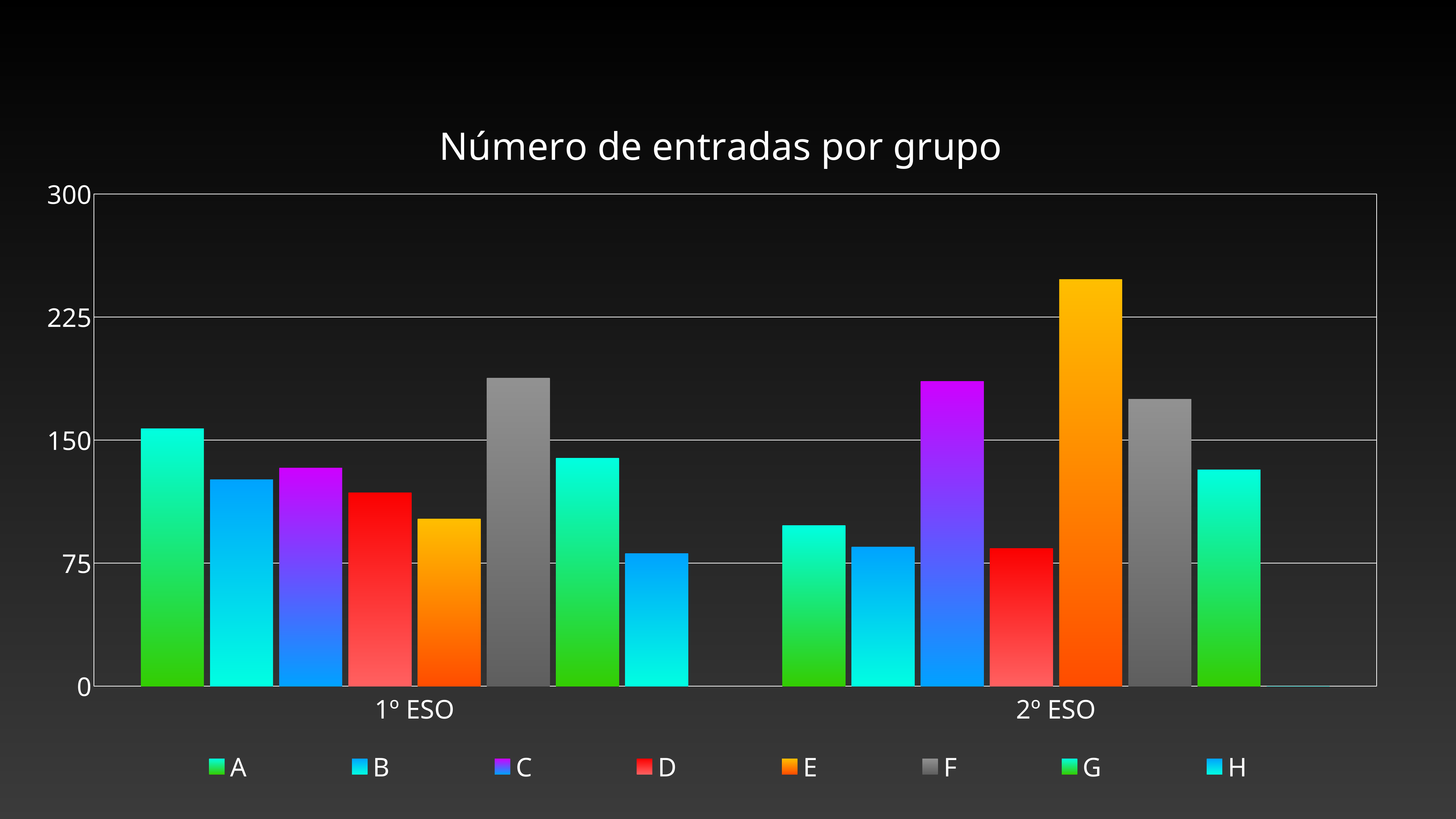
Which series has the highest value for 1º ESO? F Is the value for series A in 2º ESO greater or less than 150? less How many categories are shown on the x axis? 2 What is the title of the chart? Número de entradas por grupo Which series has the lowest value for 1º ESO? H Is the value for series E in 2º ESO greater or less than 225? greater Which is larger, the value for series C in 2º ESO or the value for series C in 1º ESO? 2º ESO What kind of chart is shown on the slide? bar chart Which is larger, the value for series F in 1º ESO or the value for series F in 2º ESO? 1º ESO Which series has the highest value for 2º ESO? E Is the value for series A in 1º ESO greater or less than 150? greater How many series does the legend list? 8